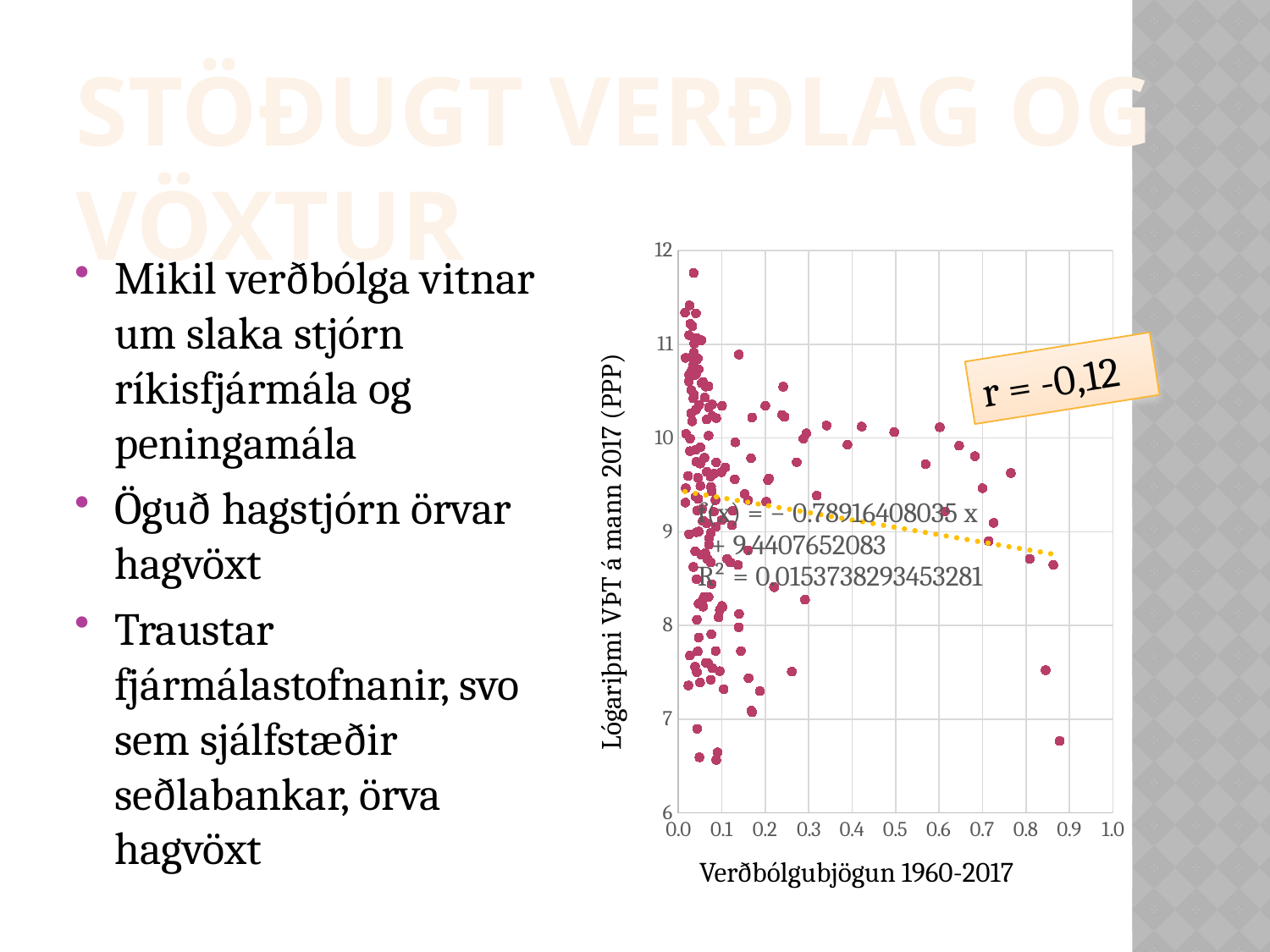
What correlation coefficient r is shown in the callout on the chart? r = -0,12 What kind of chart is shown on the slide? scatter chart Is the y value of the highest point on the chart greater or less than 11? greater What is the highest value shown on the y axis? 12 What is the label of the x axis of the chart? Verðbólgubjögun 1960-2017 What is the slope of the trendline equation printed on the chart? -0.78916408035 What R² value is printed on the chart for the trendline? 0.0153738293453281 What is the label of the y axis of the chart? Lógariþmi VÞT á mann 2017 (PPP) Is the y value of the lowest point near x = 0.9 greater or less than 7? less What is the intercept of the trendline equation printed on the chart? 9.4407652083 Does the dotted trendline rise or fall as the x-axis value increases? fall